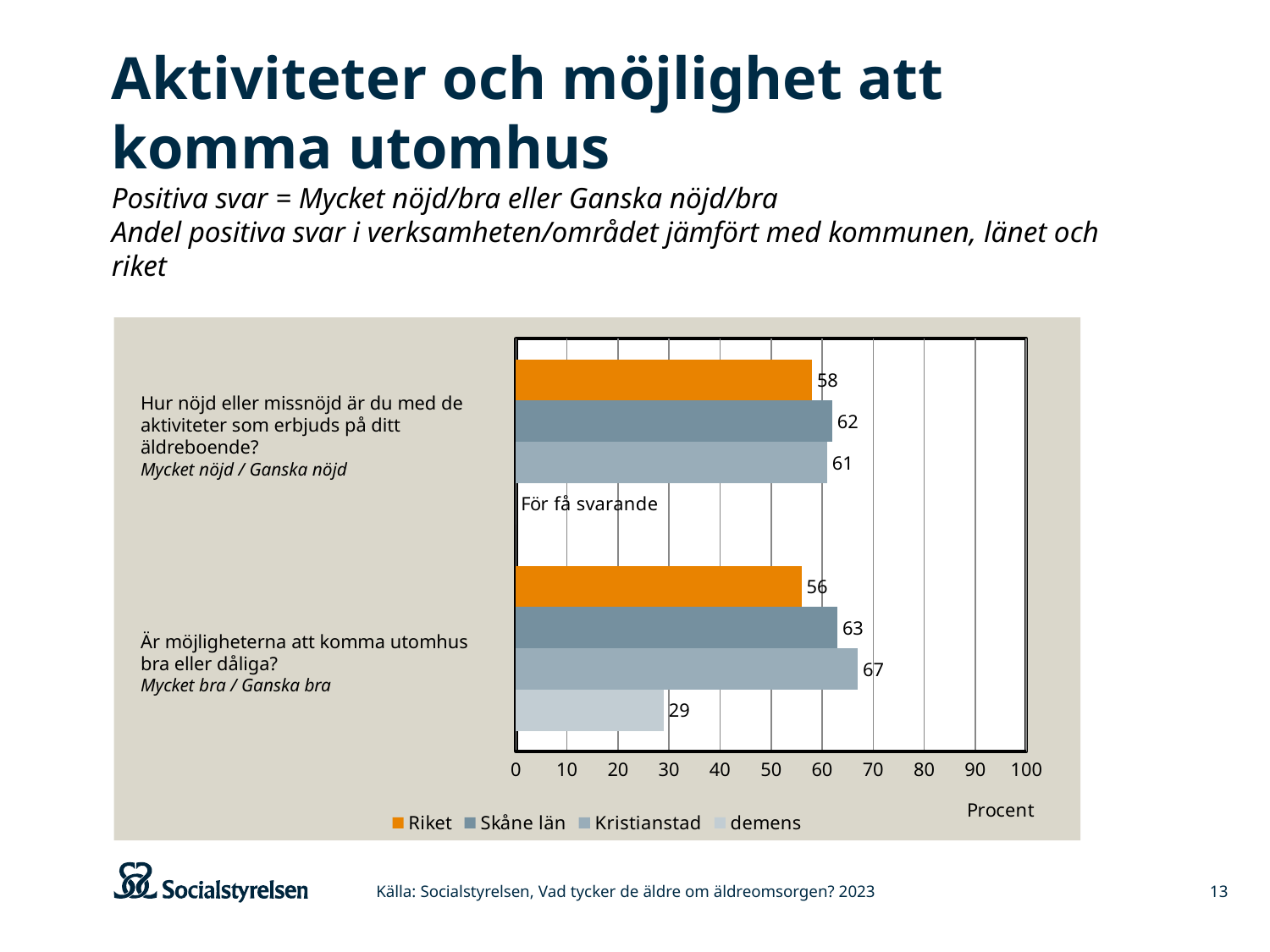
What is the value for Kristianstad for the question about opportunities to get outdoors ("Är möjligheterna att komma utomhus bra eller dåliga?")? 67 What kind of chart is shown on the slide? Bar chart How many series does the legend list? 4 What is the value for Riket for the question about activities offered at the care home ("Hur nöjd eller missnöjd är du med de aktiviteter som erbjuds på ditt äldreboende?")? 58 What is the value for demens for the question about opportunities to get outdoors? 29 Which is larger for the question about activities offered at the care home: Skåne län or Riket? Skåne län What is the value for Skåne län for the question about activities offered at the care home? 62 Which series has the highest value for the question about opportunities to get outdoors? Kristianstad What is the difference between Kristianstad and demens for the question about opportunities to get outdoors? 38 What is shown instead of a value for the demens series for the question about activities offered at the care home? För få svarande What unit is labelled on the x axis? Procent Which series has the lowest value for the question about opportunities to get outdoors? demens